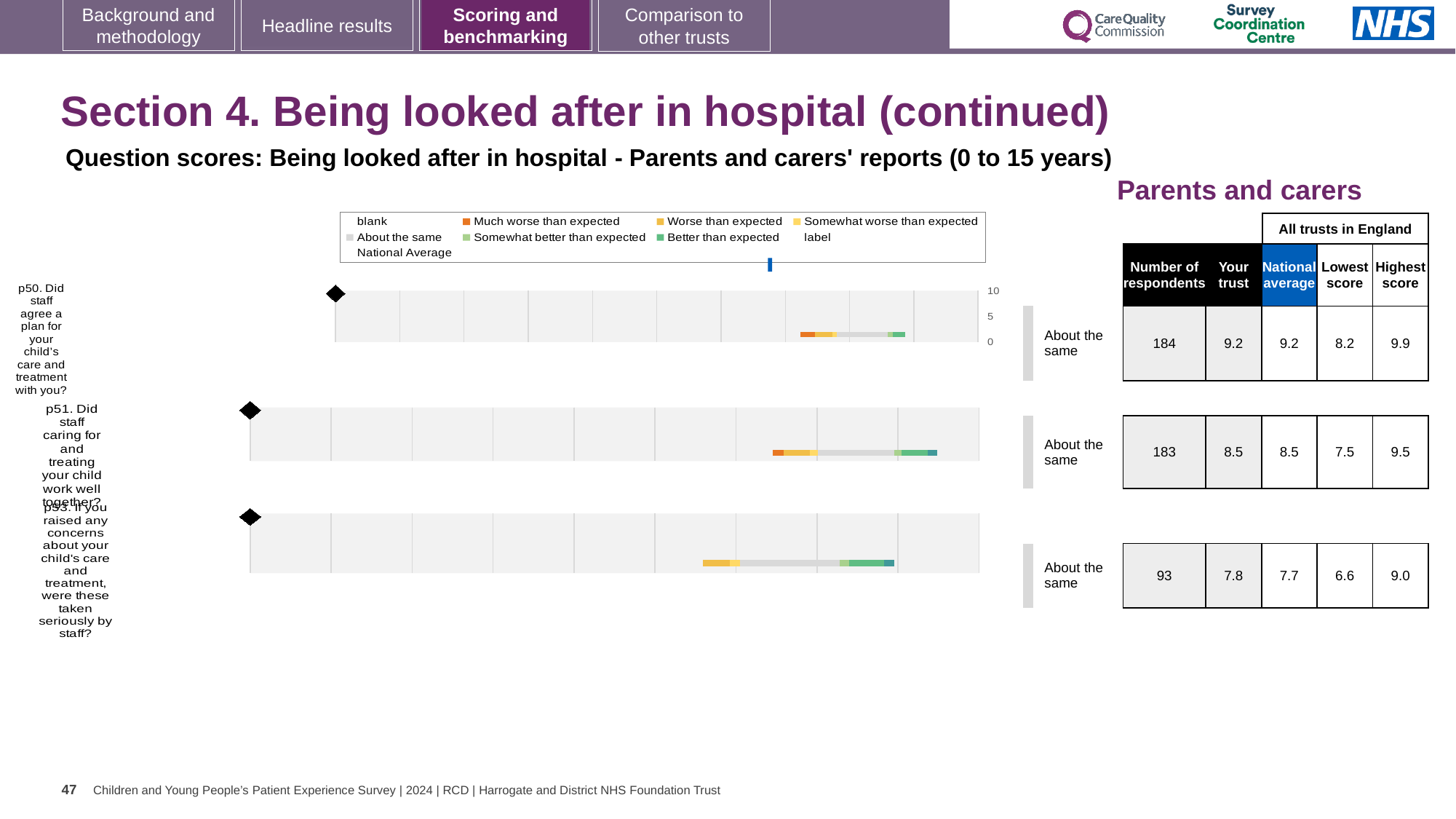
What is the lowest score among all trusts in England for p53? 6.6 What kind of chart is used to show the question scores on this slide? bar chart What is the difference between the highest and lowest trust scores for p53? 2.4 What is the 'Your trust' score for p50 (Did staff agree a plan for your child's care and treatment with you?)? 9.2 What benchmark category is shown for p51? About the same Which question has the fewest respondents? p53 In the legend, which colour represents 'Much worse than expected'? orange Which question has the higher 'Your trust' score, p50 or p53? p50 How many questions (p50, p51, p53) have a chart on this slide? 3 What is the national average score for p53 (If you raised any concerns about your child's care and treatment, were these taken seriously by staff?)? 7.7 What is the highest score among all trusts in England for p50? 9.9 How many respondents answered p51 (Did staff caring for and treating your child work well together?)? 183